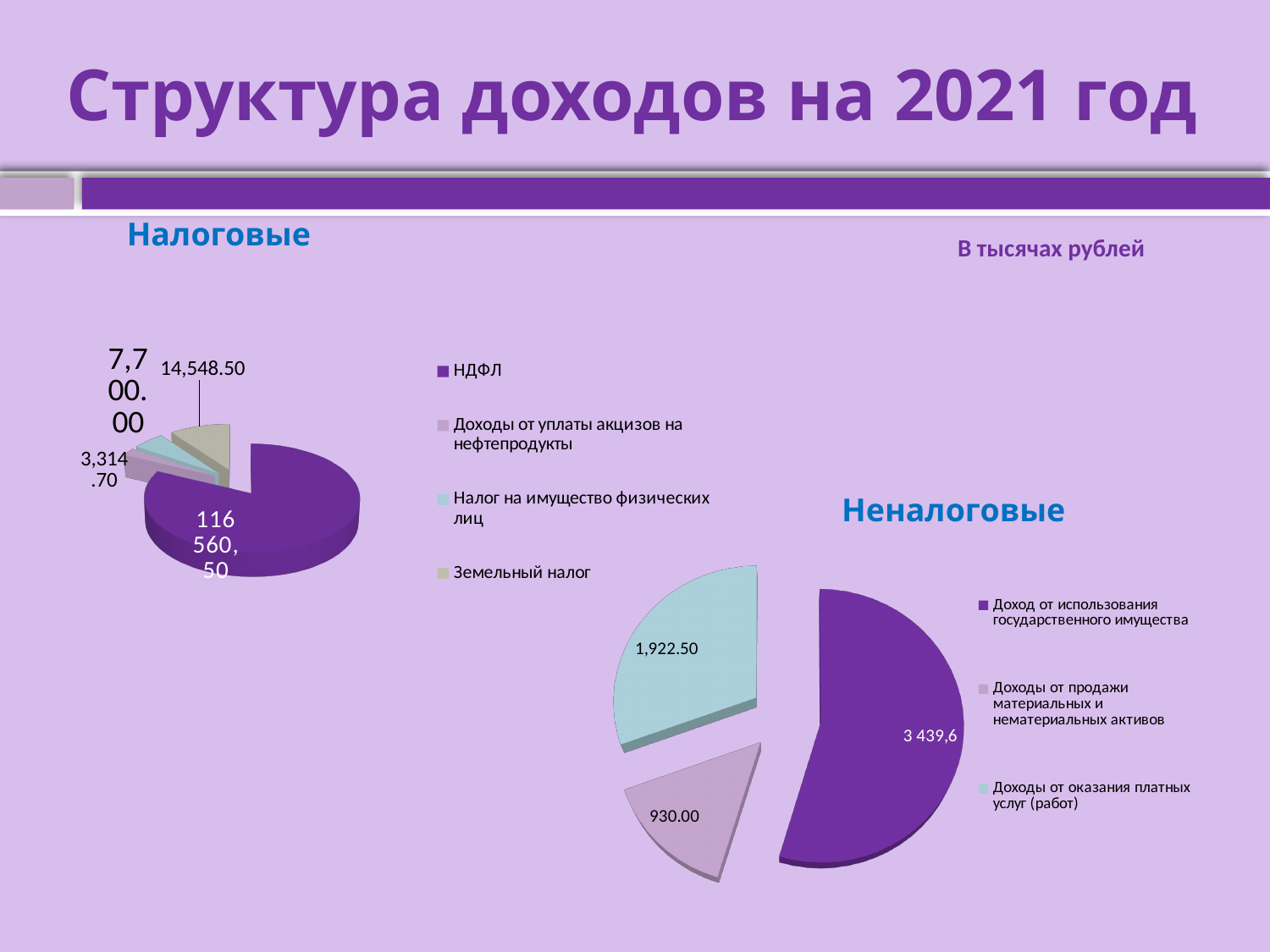
In the 'Налоговые' chart, what is the value for Налог на имущество физических лиц? 7,700.00 What type of chart is used for the 'Налоговые' data? pie chart In the 'Налоговые' chart, what is the value for Доходы от уплаты акцизов на нефтепродукты? 3,314.70 In the 'Неналоговые' chart, what is the value for Доходы от оказания платных услуг (работ)? 1,922.50 In the 'Неналоговые' chart, which category has the largest value? Доход от использования государственного имущества In the 'Налоговые' chart, what is the value for Земельный налог? 14,548.50 How many categories does the legend of the 'Налоговые' chart list? 4 In the 'Налоговые' chart, what is the difference between Земельный налог and Налог на имущество физических лиц? 6,848.50 In the 'Налоговые' chart, which category has the smallest value? Доходы от уплаты акцизов на нефтепродукты In the 'Неналоговые' chart, which is larger: Доходы от оказания платных услуг (работ) or Доходы от продажи материальных и нематериальных активов? Доходы от оказания платных услуг (работ) In the 'Налоговые' chart, which category has the largest value? НДФЛ In the 'Неналоговые' chart, what is the value for Доходы от продажи материальных и нематериальных активов? 930.00